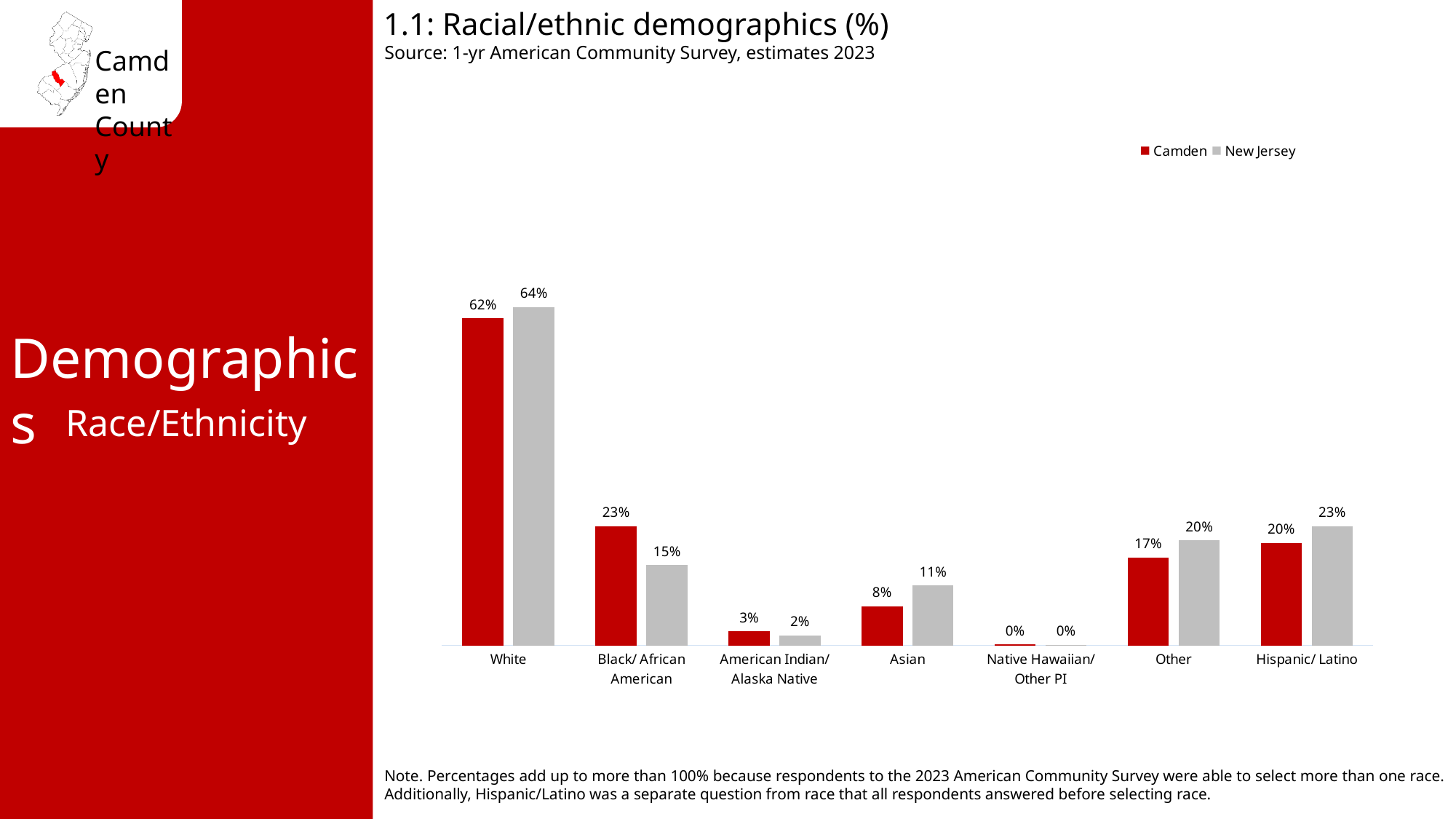
How many series does the legend list? 2 What kind of chart is shown? Bar chart What is the Camden value for White? 62% Which is larger for Other: the Camden value or the New Jersey value? New Jersey Which category has the highest Camden value? White What is the Camden value for Black/ African American? 23% What is the title of the chart? 1.1: Racial/ethnic demographics (%) What is the New Jersey value for Asian? 11% Which category has the lowest New Jersey value? Native Hawaiian/ Other PI What is the New Jersey value for Hispanic/ Latino? 23% How many categories are shown on the x axis? 7 What is the difference between the Camden and New Jersey values for Black/ African American? 8%